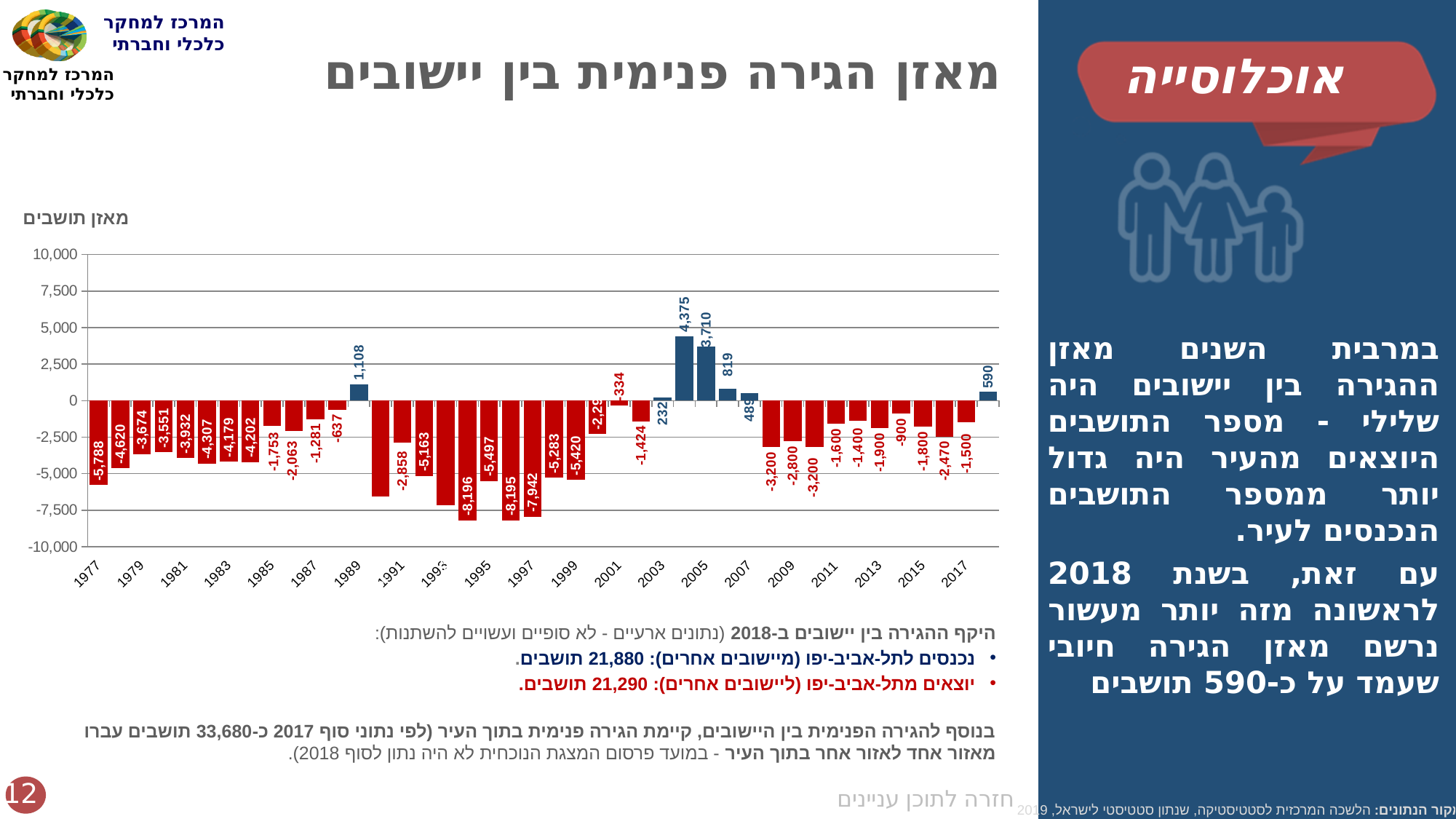
What kind of chart is shown on the slide? bar chart What is the title shown above the vertical axis of the chart? מאזן תושבים What is the highest value shown in the chart? 4,375 What is the migration balance value for 1977? -5,788 How many bars in the chart show a positive value? 7 What is the migration balance value for 1989? 1,108 Is the value for 1977 greater or less than -5,000? less What is the lowest value shown in the chart? -8,196 What is the difference between the two tallest positive bars, 4,375 and 3,710? 665 What colour are the bars with negative values? red Which is larger, the value for 1977 or the value for 2018? 2018 What is the migration balance value for 2018 (the last bar)? 590